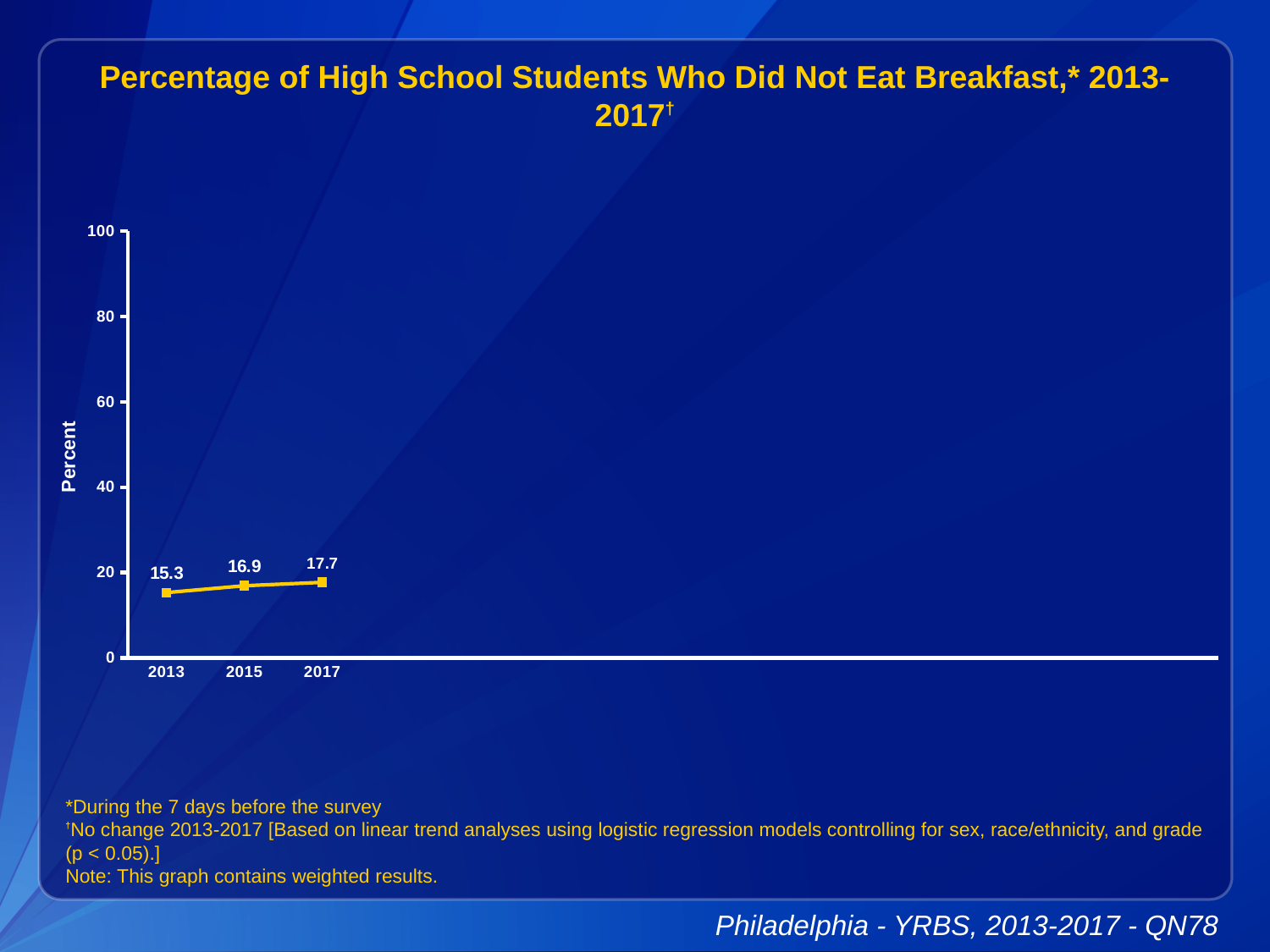
What kind of chart is shown on the slide? line chart Which year has a larger value, 2015 or 2017? 2017 What percentage of high school students did not eat breakfast in 2017? 17.7 What percentage of high school students did not eat breakfast in 2015? 16.9 What is the difference between the 2015 and 2013 values? 1.6 How many years are plotted on the chart? 3 Which year has the lowest percentage of students who did not eat breakfast? 2013 What percentage of high school students did not eat breakfast in 2013? 15.3 Which year has the highest percentage of students who did not eat breakfast? 2017 Is the value for 2013 greater or less than 20? less Do the values rise or fall from 2013 to 2017? rise What is the difference between the 2017 and 2013 values? 2.4